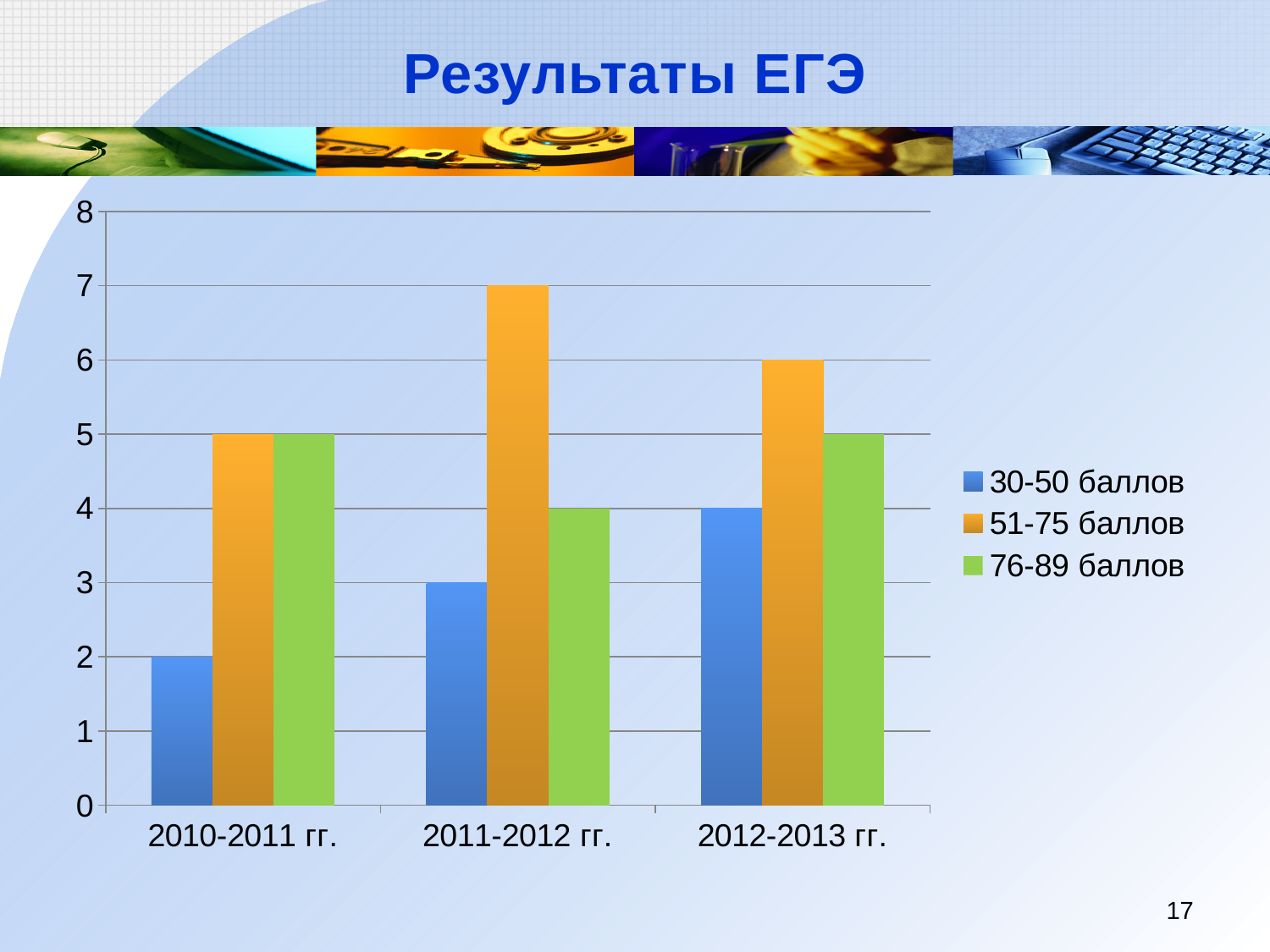
What is the value for 30-50 баллов in 2010-2011 гг.? 2 What is the difference between the 51-75 баллов value and the 30-50 баллов value in 2011-2012 гг.? 4 How many series does the legend list? 3 What is the value for 76-89 баллов in 2012-2013 гг.? 5 In which year is the value for 30-50 баллов lowest? 2010-2011 гг. Which is larger in 2012-2013 гг.: 51-75 баллов or 76-89 баллов? 51-75 баллов How many categories are shown on the x axis? 3 Do the values for 30-50 баллов rise or fall from 2010-2011 гг. to 2012-2013 гг.? rise In which year is the value for 51-75 баллов highest? 2011-2012 гг. What kind of chart is shown on the slide? bar chart What is the value for 51-75 баллов in 2011-2012 гг.? 7 What is the title of the slide? Результаты ЕГЭ